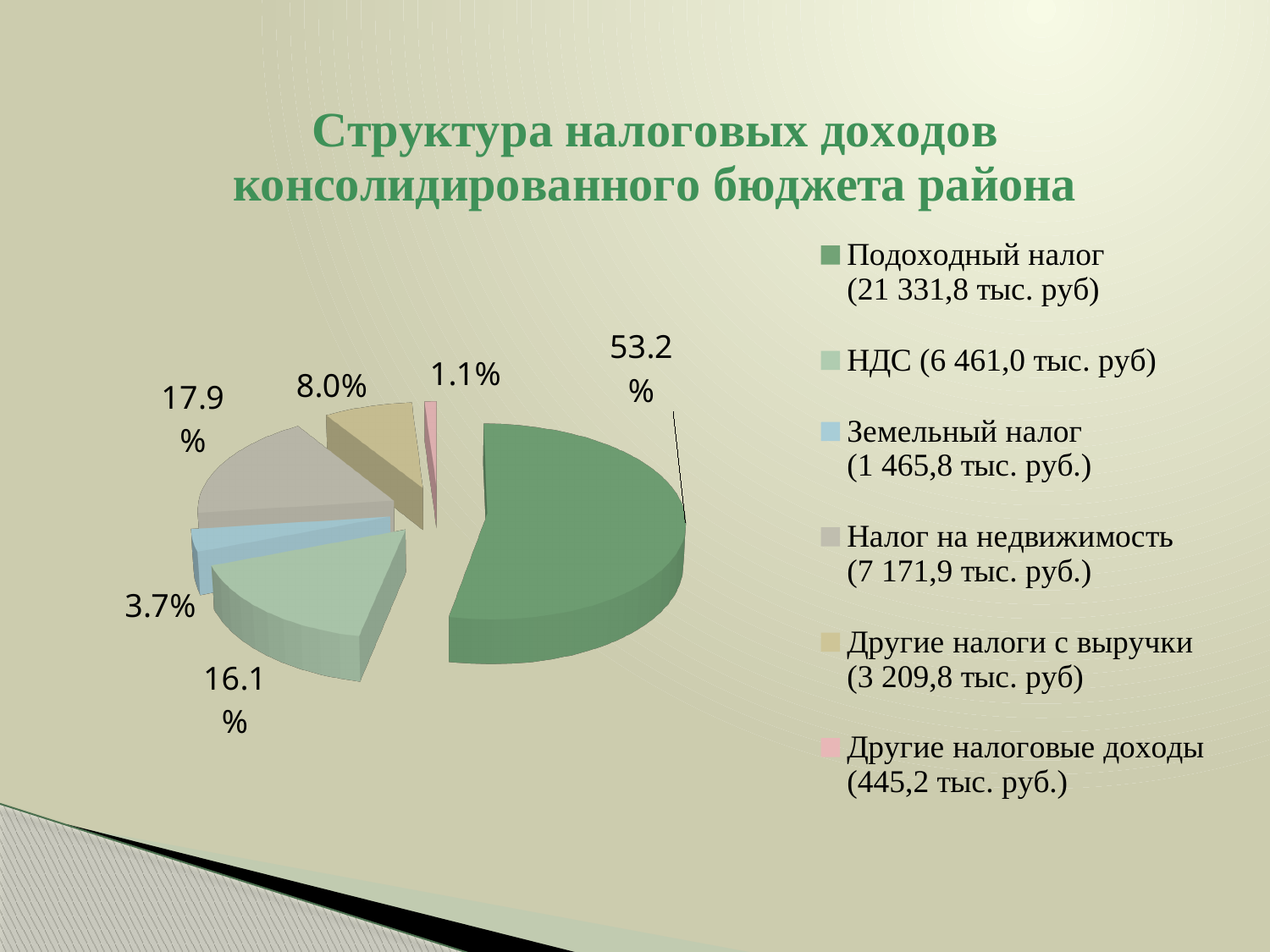
Which has a larger share, Другие налоги с выручки or Земельный налог? Другие налоги с выручки What share of the pie does Земельный налог have? 3.7% How many slices does the pie chart have? 6 Which category has the largest share of the pie? Подоходный налог Which category has the smallest share of the pie? Другие налоговые доходы What share of the pie does Подоходный налог have? 53.2% What kind of chart is shown on the slide? Pie chart What amount in thousand rubles does the legend give for Подоходный налог? 21 331,8 тыс. руб What is the difference in percentage points between the shares of Налог на недвижимость and НДС? 1.8 What share of the pie does Налог на недвижимость have? 17.9%